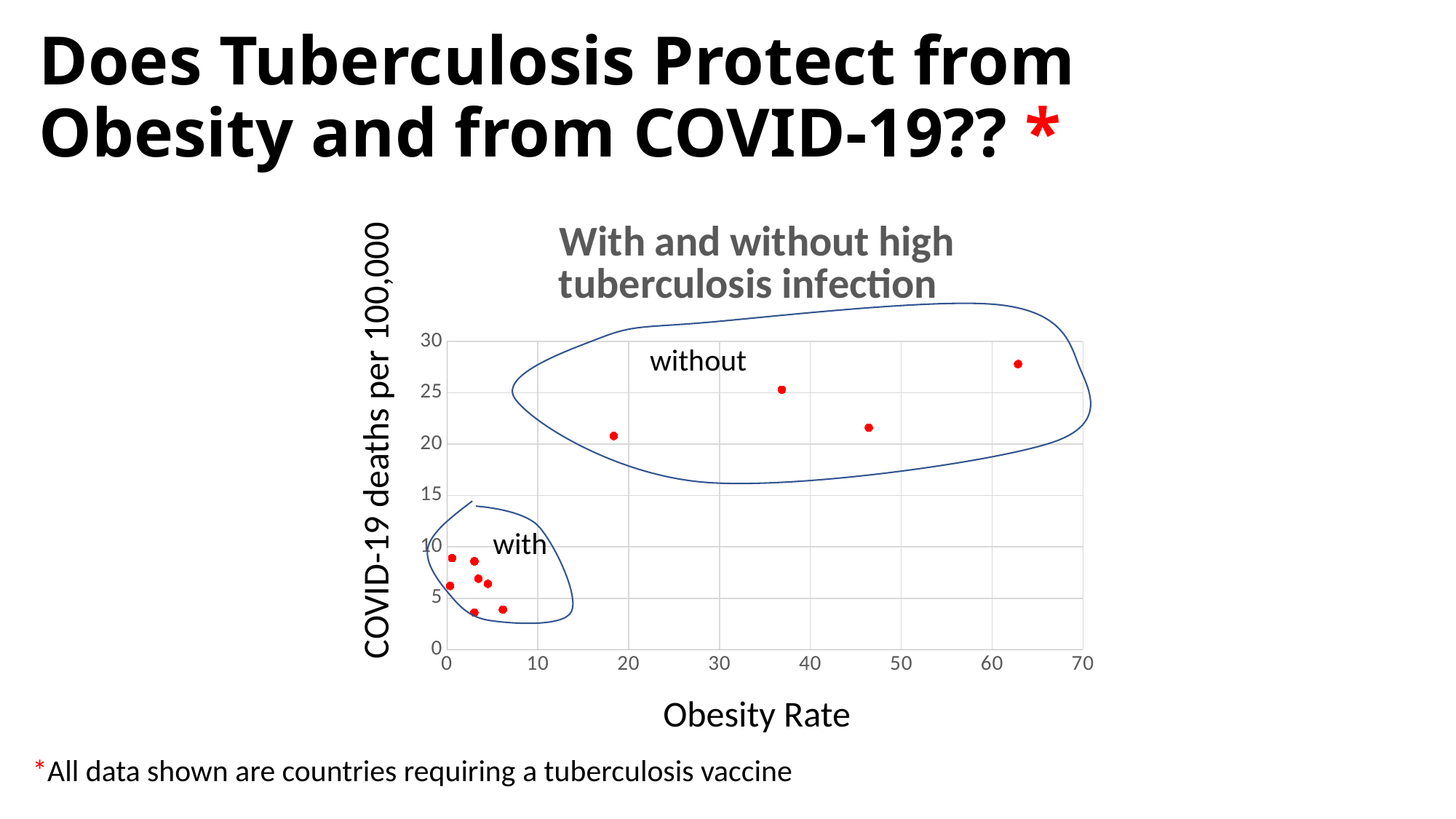
Which circled group, "with" or "without", contains the point with the highest COVID-19 deaths per 100,000? without Which group has higher obesity rates overall, "with" or "without"? without What is the maximum value shown on the x axis? 70 Which circled group, "with" or "without", contains the point with the lowest COVID-19 deaths per 100,000? with Is the obesity rate of the rightmost point greater or less than 60? greater Is the COVID-19 deaths value for the point with the highest obesity rate greater or less than 25? greater What kind of chart is shown on the slide? scatter chart Are all points in the "with" group below 10 COVID-19 deaths per 100,000? yes What is the title of the chart? With and without high tuberculosis infection What is the label of the x axis? Obesity Rate How many data points are circled in the "without" group? 4